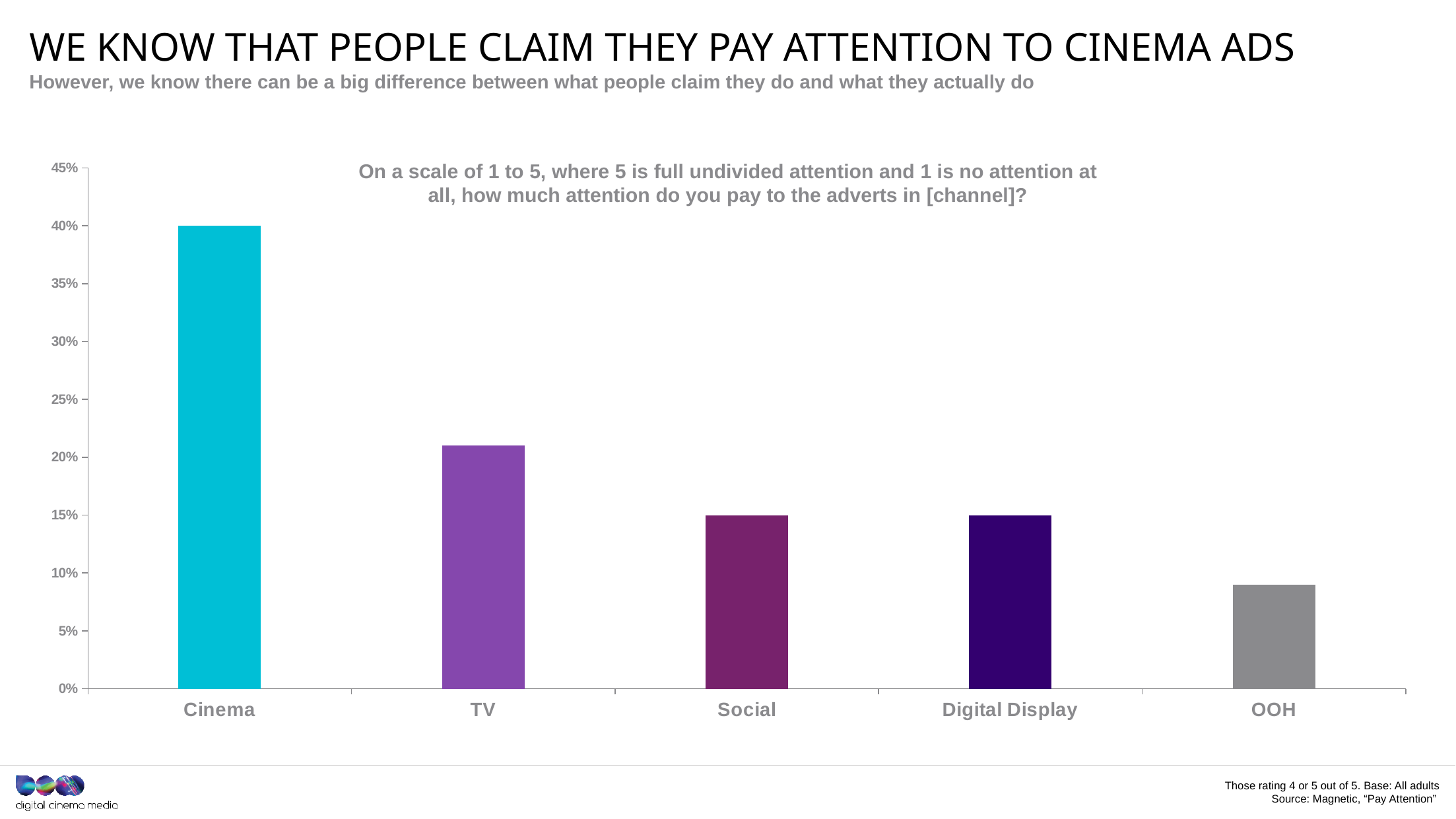
Which is larger, the value for TV or the value for OOH? TV How many channels are shown on the x axis of the chart? 5 What kind of chart is shown on the slide? bar chart What is the value for Social? 15% What is the highest value shown on the y axis of the chart? 45% Is the value for Digital Display greater or less than 20%? less Is the value for OOH greater or less than 10%? less Which channel has the highest share of people claiming to pay attention to its adverts? Cinema Which is larger, the value for Cinema or the value for TV? Cinema What is the value for Cinema? 40% Is the value for TV greater or less than 20%? greater Which channel has the lowest bar in the chart? OOH